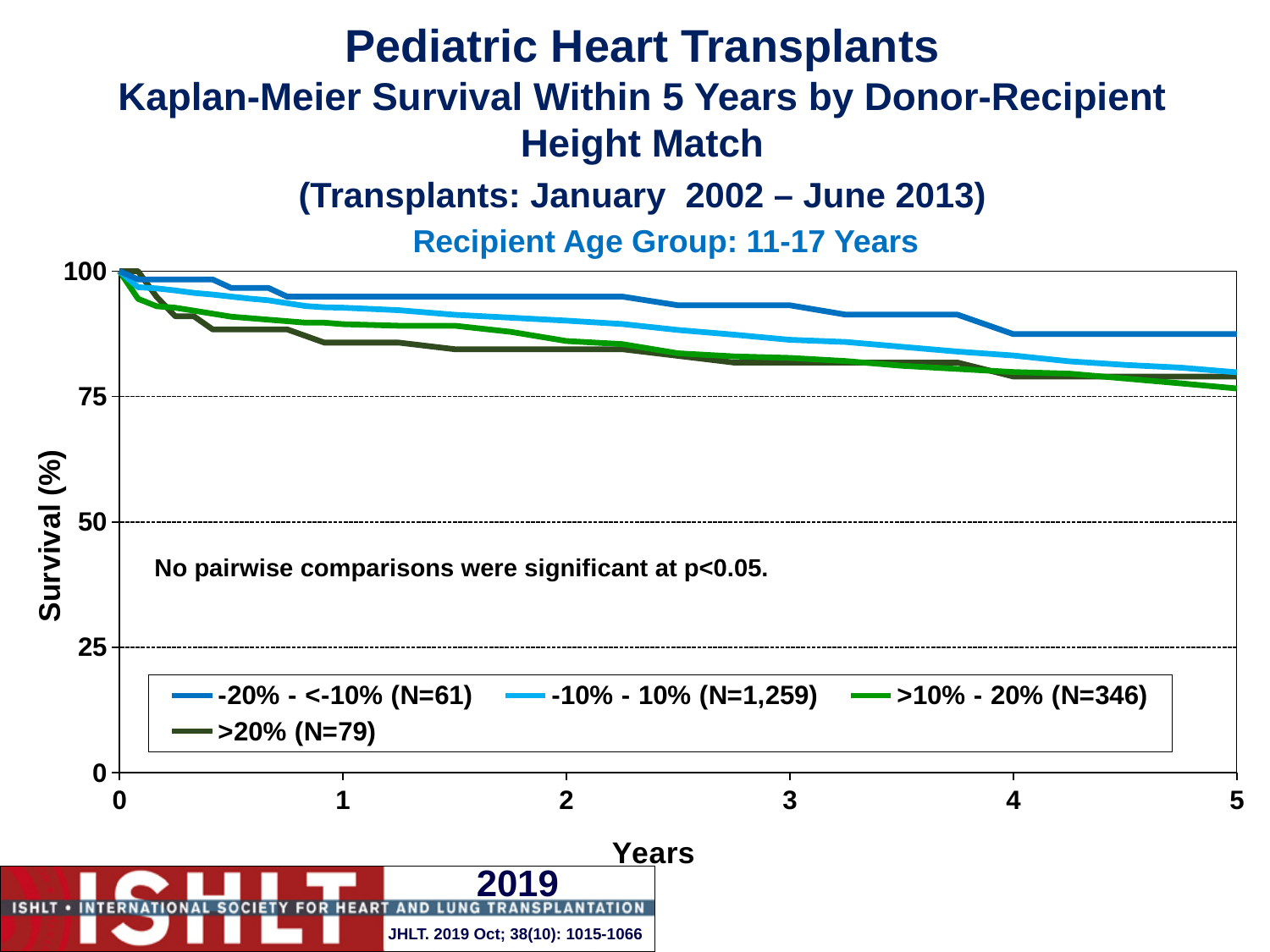
What does the annotation on the chart say about pairwise comparisons? No pairwise comparisons were significant at p<0.05. What is the label of the y axis? Survival (%) What is the N for the -10% - 10% height-match group shown in the legend? 1,259 Which height-match group has the highest survival at year 5? -20% - <-10% (N=61) How many series does the legend list? 4 Which height-match group has the lowest survival at year 1? >20% (N=79) Do the survival curves rise or fall as years increase along the x axis? Fall Is the survival value for the >10% - 20% group at year 2 greater or less than 75? greater At year 4, which is larger: survival for the -20% - <-10% group or the >10% - 20% group? -20% - <-10% group What kind of chart is shown on the slide? Line chart Is the survival value for the -10% - 10% group at year 3 greater or less than 75? greater Is the survival value for the -20% - <-10% group at year 5 greater or less than 75? greater